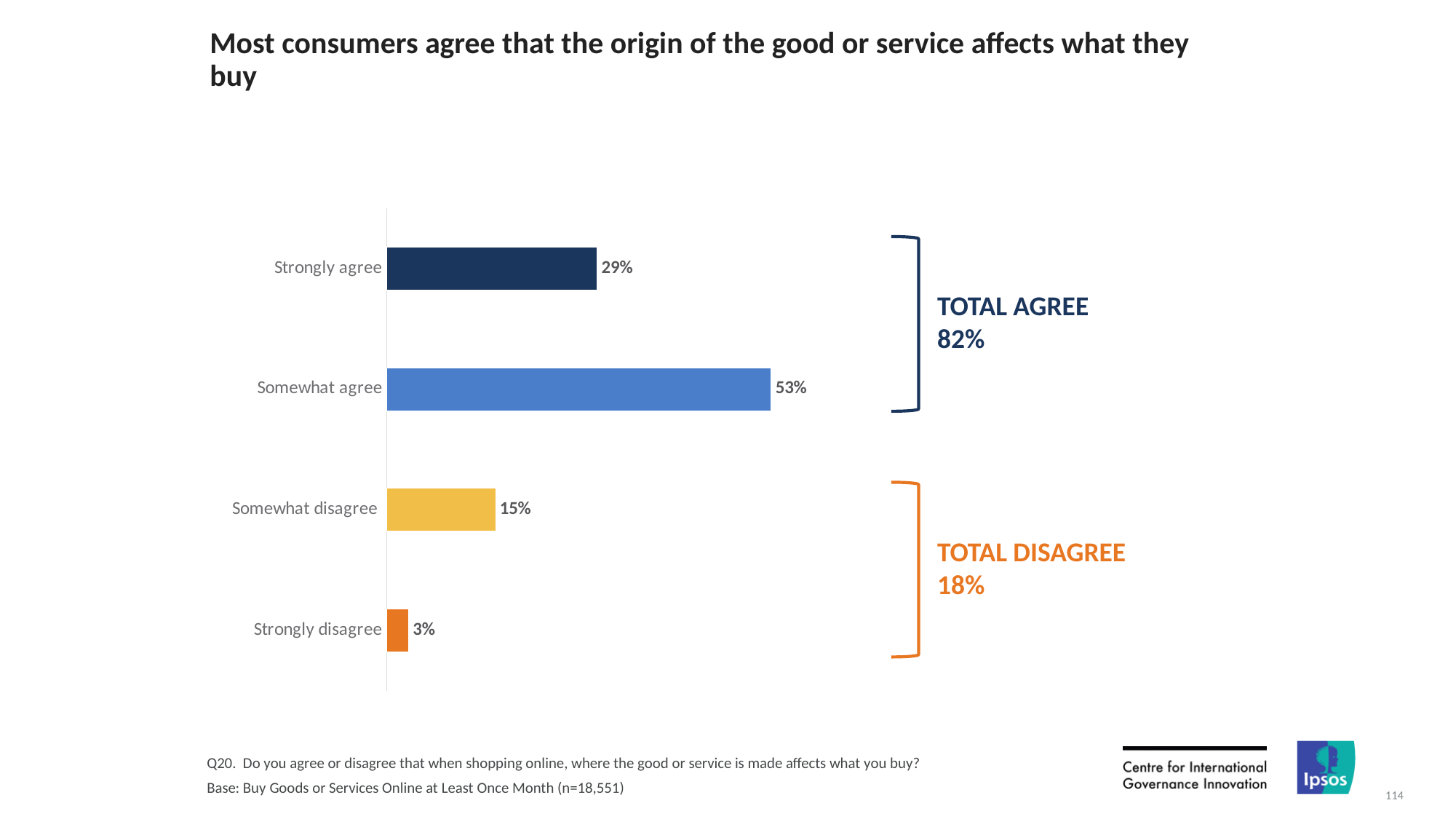
Which is larger: the percentage who strongly agree or the percentage who somewhat disagree? Strongly agree What percentage of respondents somewhat disagree? 15% What percentage of respondents strongly disagree? 3% Which response category has the lowest percentage? Strongly disagree Which response category has the highest percentage? Somewhat agree What type of chart is shown on the slide? Bar chart How many response categories are shown in the chart? 4 What percentage of respondents somewhat agree? 53% What is the difference between the percentage who somewhat agree and the percentage who strongly agree? 24 percentage points What is the total agree percentage shown on the slide? 82% What percentage of respondents strongly agree that the origin of the good or service affects what they buy? 29% What is the total disagree percentage shown on the slide? 18%